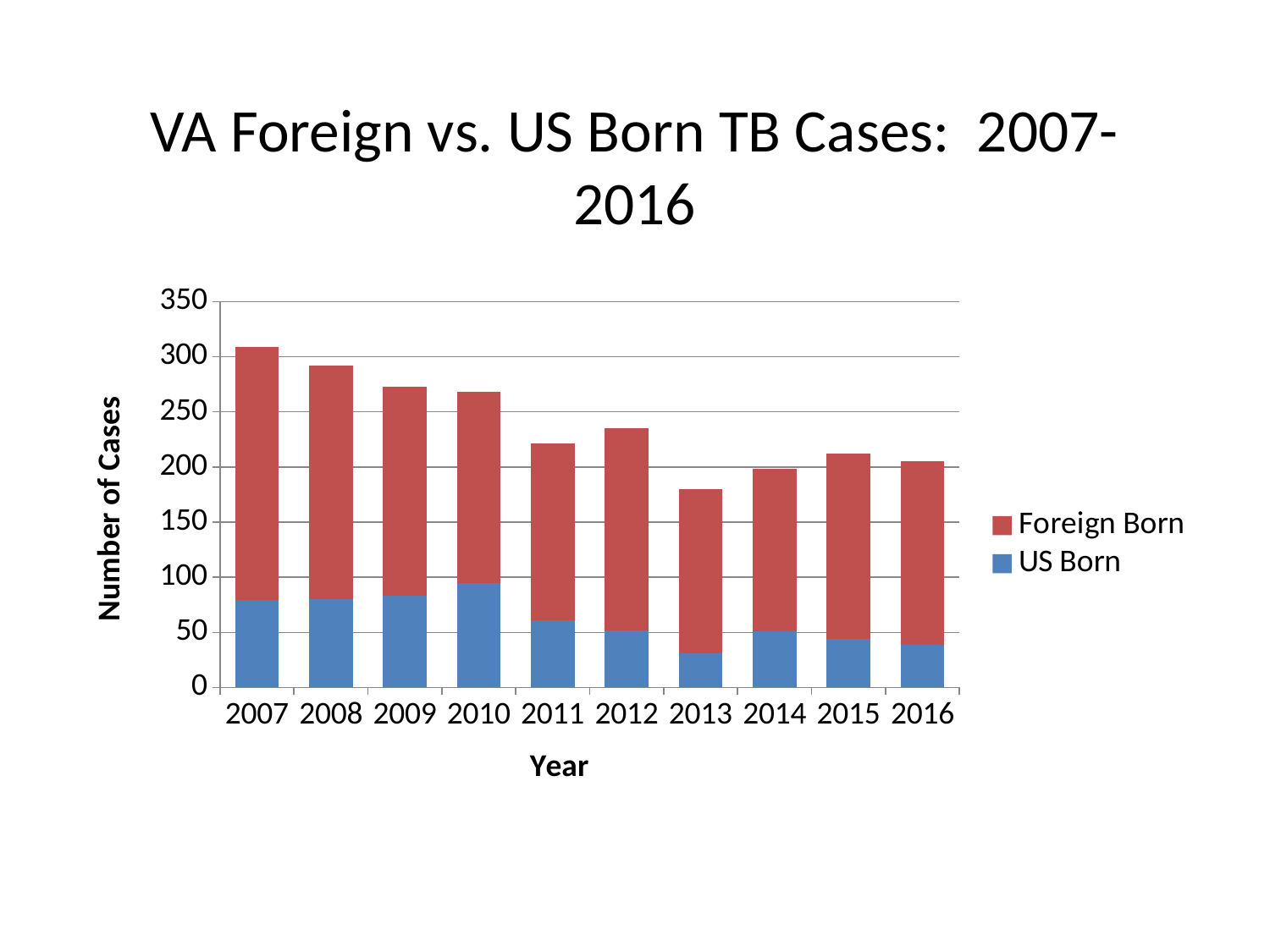
How many years are shown on the x axis? 10 Which year has the lowest number of US Born cases? 2013 Which year has the highest number of US Born cases? 2010 Which year has the highest total number of TB cases? 2007 Is the total number of cases in 2013 greater or less than 200? less What kind of chart is shown on the slide? Stacked bar chart Overall, do total TB cases rise or fall from 2007 to 2016? fall Is the total number of cases in 2007 greater or less than 300? greater Which year has the lowest total number of TB cases? 2013 How many series does the legend list? 2 Which year has a larger total number of cases, 2011 or 2012? 2012